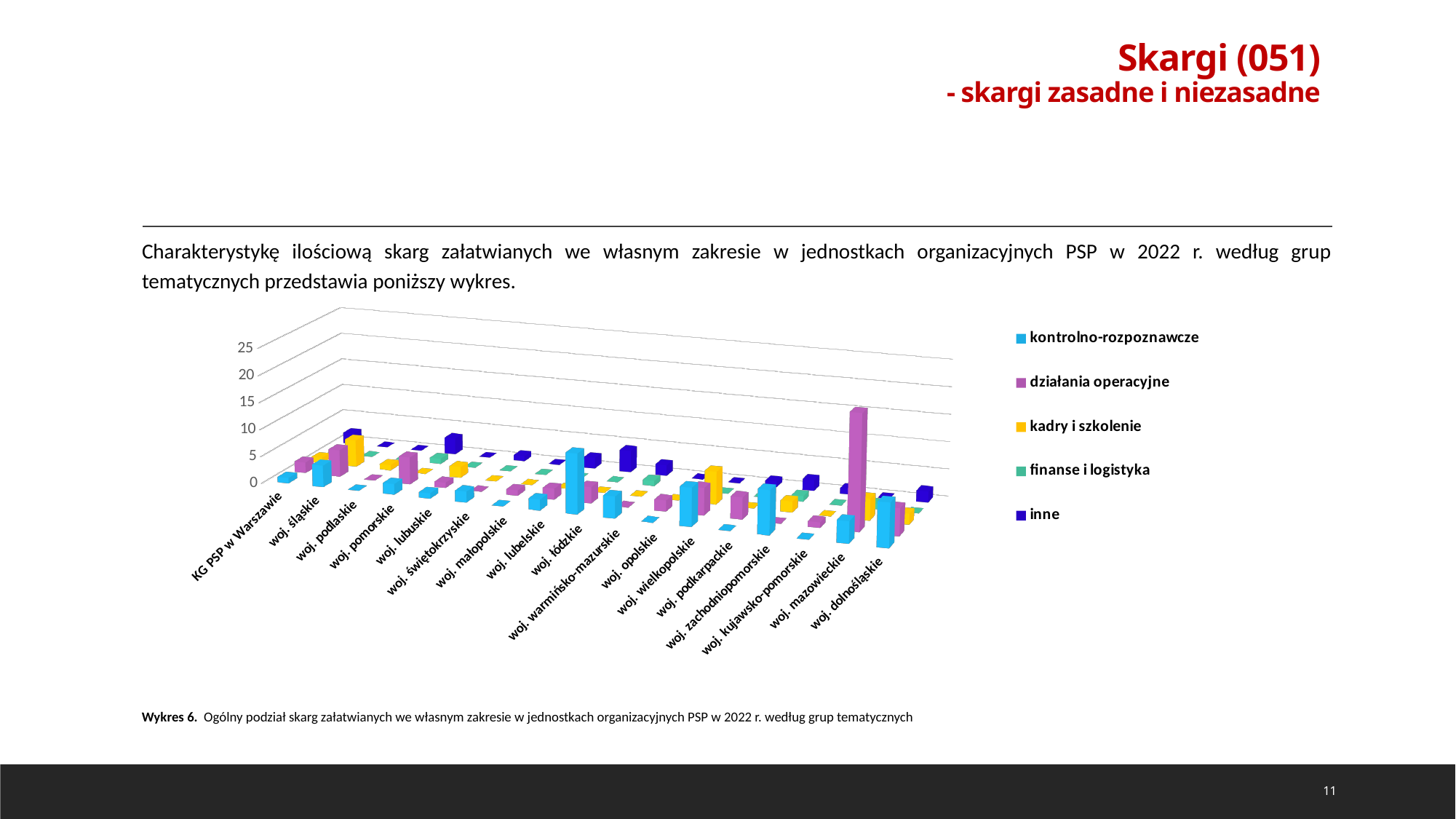
Which series does the tallest bar in the chart belong to? działania operacyjne How many categories are shown on the x axis of the chart? 17 Is the value for działania operacyjne in woj. mazowieckie greater or less than 5? greater What is the first category on the x axis of the chart? KG PSP w Warszawie What is the last category on the x axis of the chart? woj. dolnośląskie Which category has the tallest bar in the chart? woj. mazowieckie Which is larger: działania operacyjne in woj. mazowieckie or kontrolno-rozpoznawcze in woj. łódzkie? działania operacyjne in woj. mazowieckie What kind of chart is shown on the slide? bar chart What is the highest value shown on the vertical axis of the chart? 25 What is the first series listed in the chart legend? kontrolno-rozpoznawcze How many series does the legend list? 5